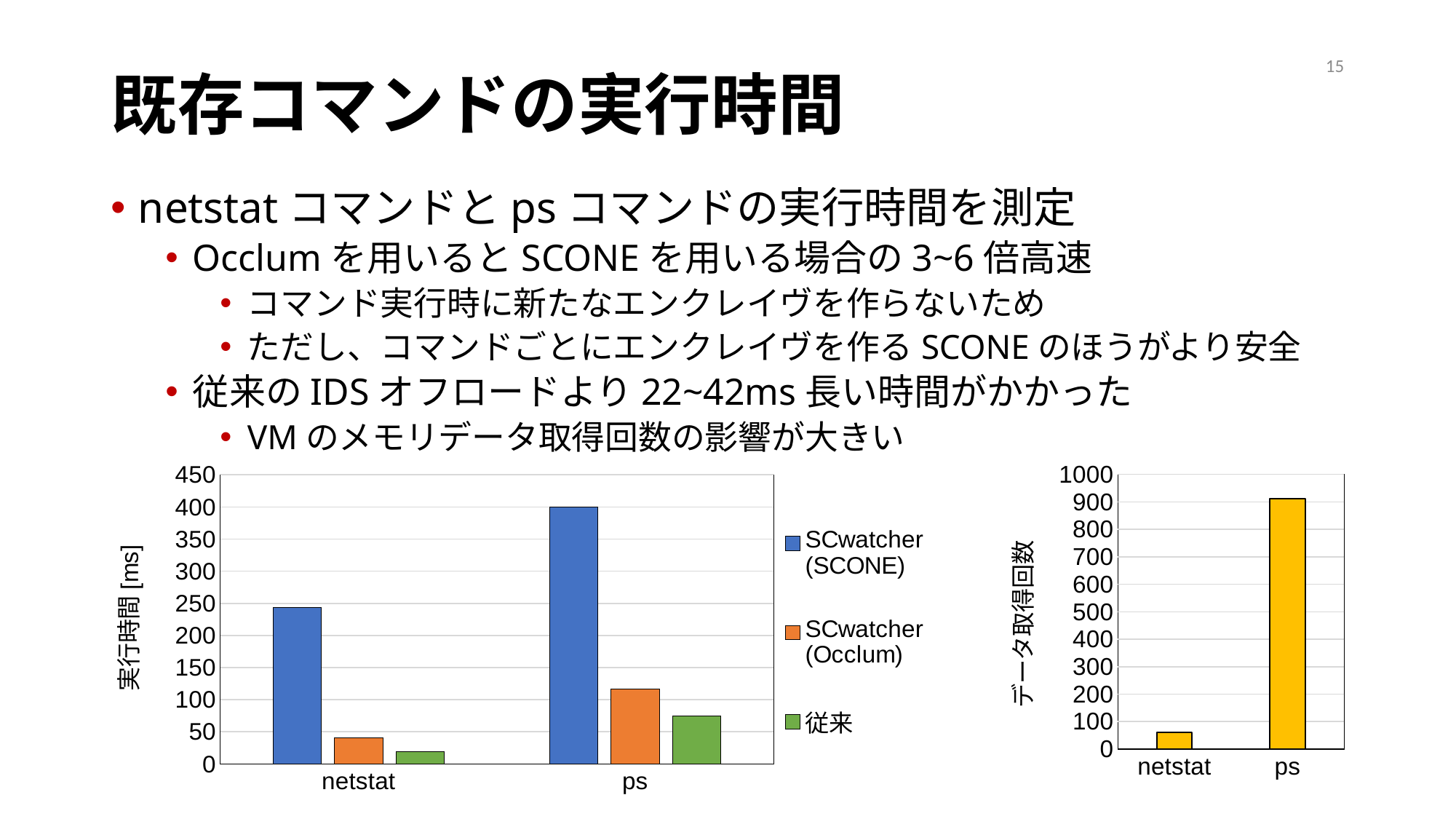
In the left chart, which is larger: SCwatcher (Occlum) for ps or SCwatcher (Occlum) for netstat? SCwatcher (Occlum) for ps How many categories are shown on the x axis of the left chart? 2 In the left chart, is the value for SCwatcher (Occlum) on ps greater or less than 150? less In the right chart (データ取得回数), which category has the highest value? ps In the right chart (データ取得回数), is the value for ps greater or less than 800? greater In the left chart, which series has the lowest value for netstat? 従来 In the right chart (データ取得回数), is the value for netstat greater or less than 100? less What kind of chart is the left chart (実行時間 [ms])? bar chart How many series does the legend of the left chart list? 3 In the left chart, which series has the highest value for ps? SCwatcher (SCONE)